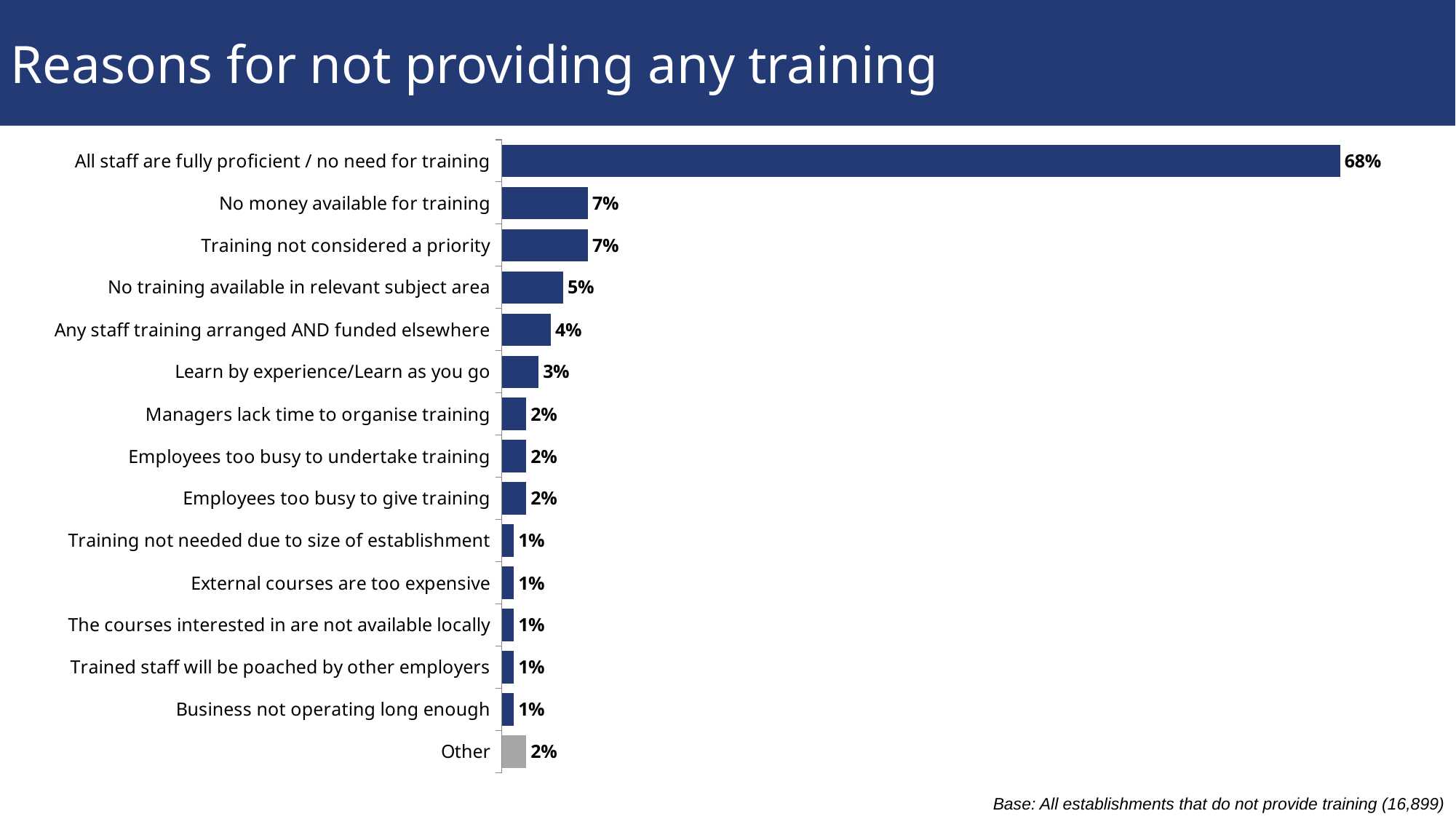
Which is larger: 'Training not considered a priority' or 'Learn by experience/Learn as you go'? Training not considered a priority Which bar is coloured grey rather than dark blue? Other What is the value for 'Other'? 2% What is the title of the slide? Reasons for not providing any training Which reason has the highest percentage? All staff are fully proficient / no need for training How many reasons (categories) are shown in the chart? 15 What is the difference between 'All staff are fully proficient / no need for training' and 'No money available for training'? 61% What percentage is shown for 'All staff are fully proficient / no need for training'? 68% What percentage is shown for 'Learn by experience/Learn as you go'? 3% What is the value for 'No training available in relevant subject area'? 5% What kind of chart is shown on the slide? Bar chart What is the difference between 'No training available in relevant subject area' and 'Any staff training arranged AND funded elsewhere'? 1%